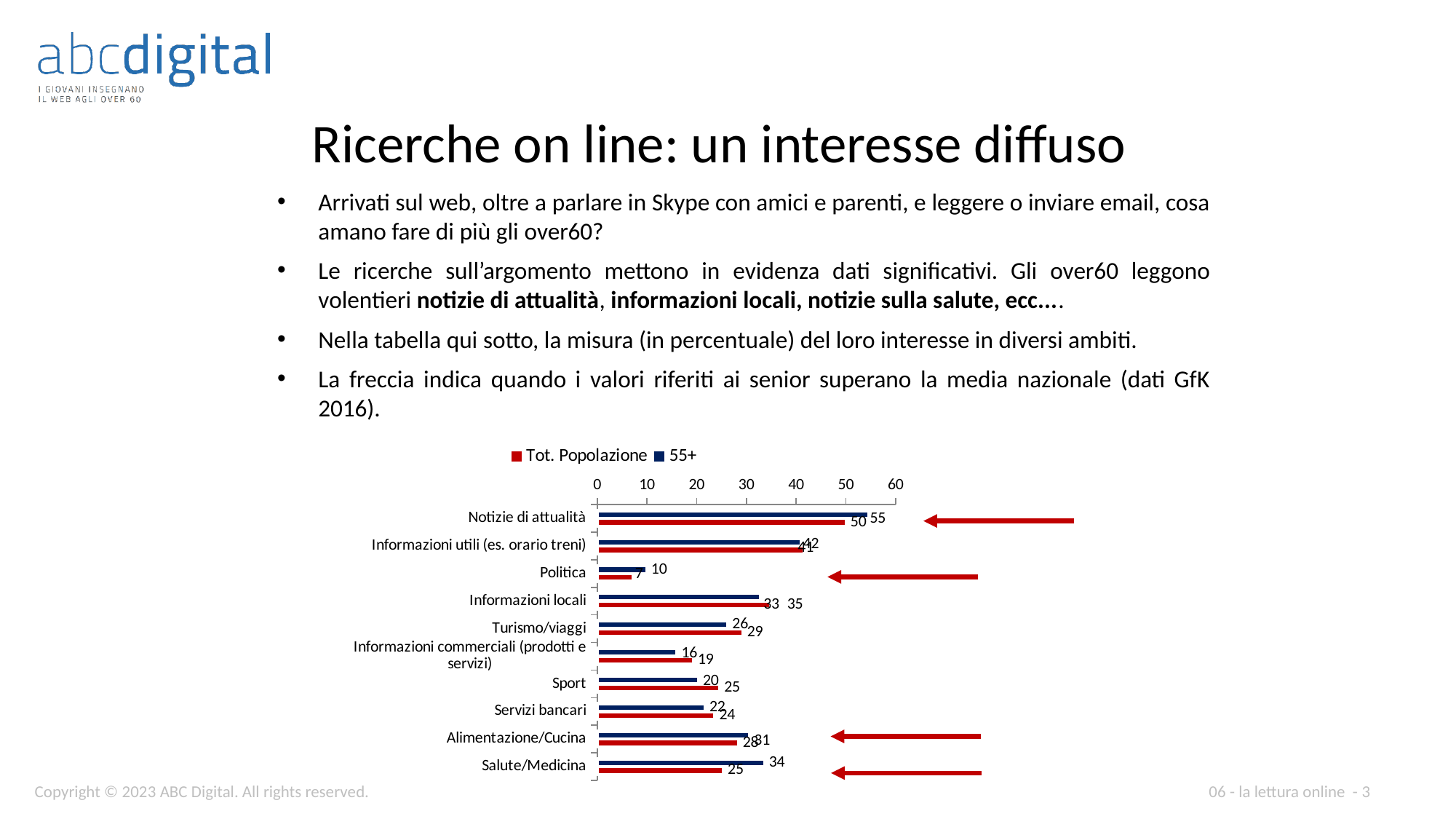
What is the value for 55+ for Notizie di attualità? 55 Which category has the lowest value for Tot. Popolazione? Politica What is the value for 55+ for Salute/Medicina? 34 What is the difference between the 55+ and Tot. Popolazione values for Salute/Medicina? 9 What kind of chart is shown on the slide? bar chart How many series does the chart legend list? 2 Which category has the highest value for 55+? Notizie di attualità Which series is shown in red in the chart legend? Tot. Popolazione For Sport, which series has the larger value, 55+ or Tot. Popolazione? Tot. Popolazione How many categories are shown on the chart? 10 What is the value for Tot. Popolazione for Politica? 7 What is the value for Tot. Popolazione for Notizie di attualità? 50